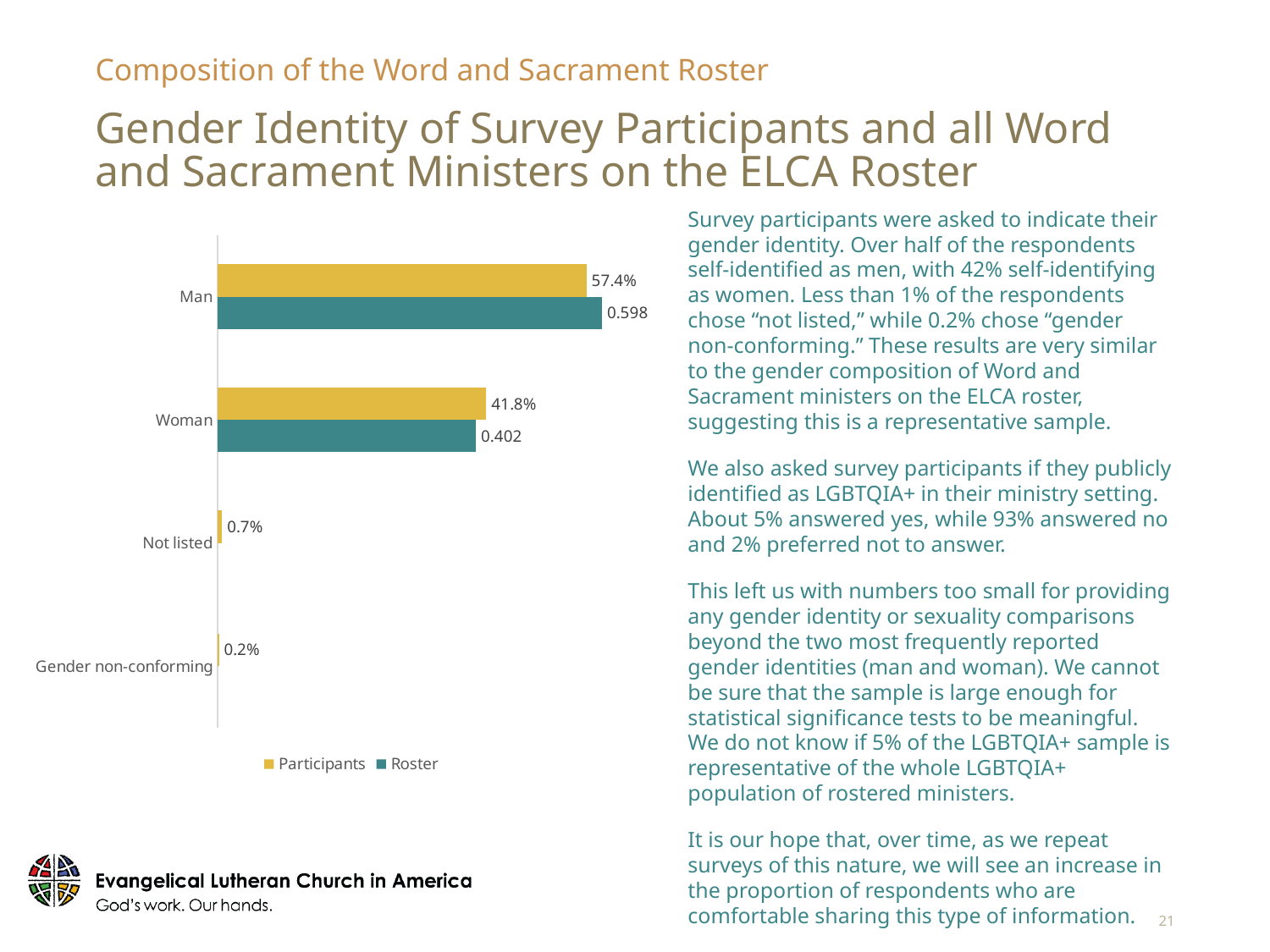
What is the Roster value for Man? 0.598 What is the difference between the Participants values for Man and Woman? 15.6% Which category has the lowest Participants value? Gender non-conforming Which is larger, the Roster value for Man or the Roster value for Woman? Man What is the Roster value for Woman? 0.402 How many series does the legend list? 2 What is the Participants value for Not listed? 0.7% What is the Participants value for Woman? 41.8% What kind of chart is shown on the slide? Bar chart What is the Participants value for Man? 57.4% What is the Participants value for Gender non-conforming? 0.2% Which category has the highest Participants value? Man